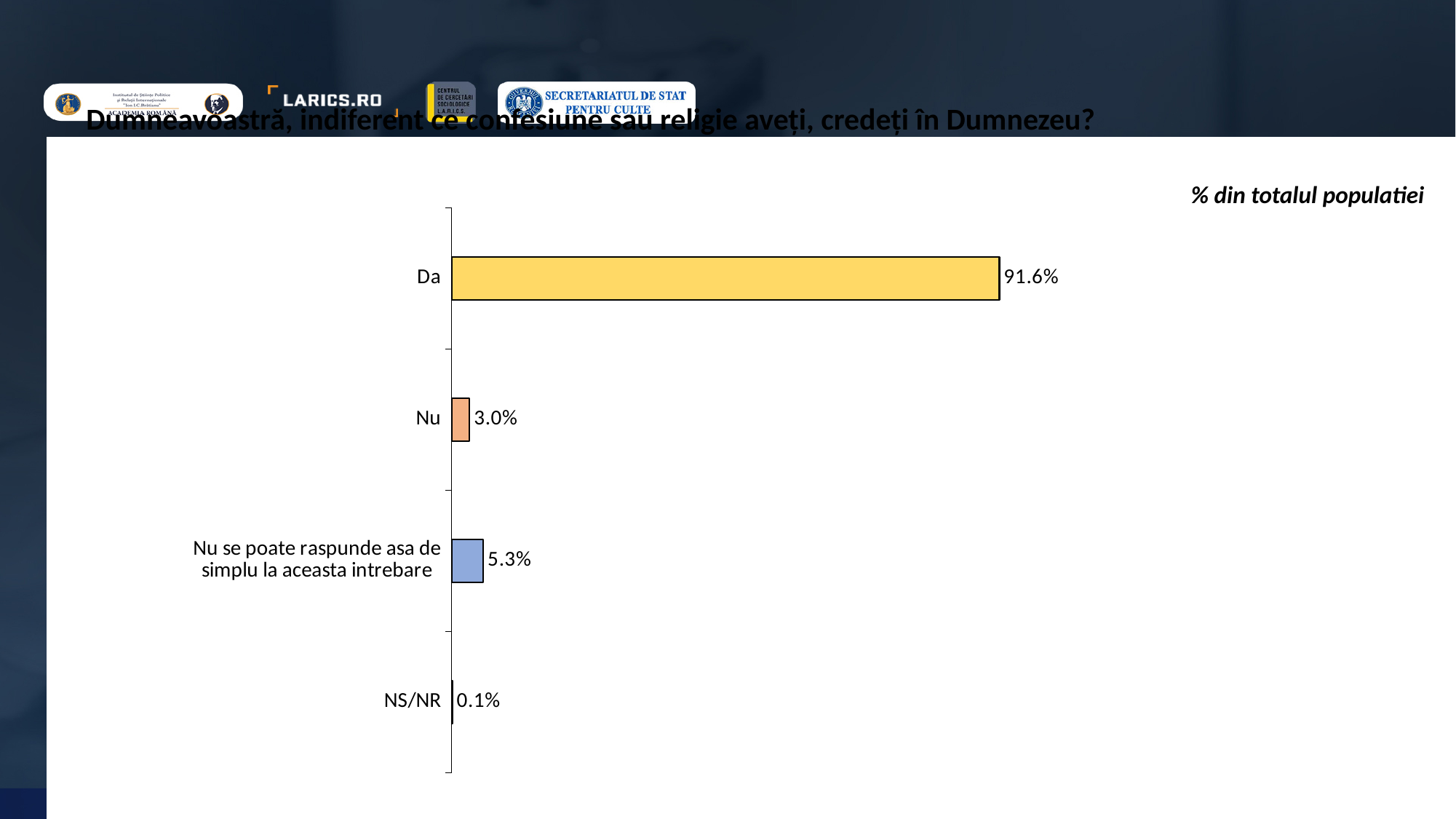
Which is larger, the value for "Nu" or the value for "Nu se poate raspunde asa de simplu la aceasta intrebare"? Nu se poate raspunde asa de simplu la aceasta intrebare What is the value for "Nu se poate raspunde asa de simplu la aceasta intrebare"? 5.3% What is the value for "Nu"? 3.0% How many categories are shown in the chart? 4 What kind of chart is shown on the slide? Bar chart What is the value for "NS/NR"? 0.1% What is the difference between the values for "Da" and "Nu"? 88.6% What is the difference between the values for "Nu se poate raspunde asa de simplu la aceasta intrebare" and "Nu"? 2.3% Which category has the highest value? Da What unit note is shown at the top right of the chart? % din totalul populatiei What is the value for "Da"? 91.6% Which category has the lowest value? NS/NR